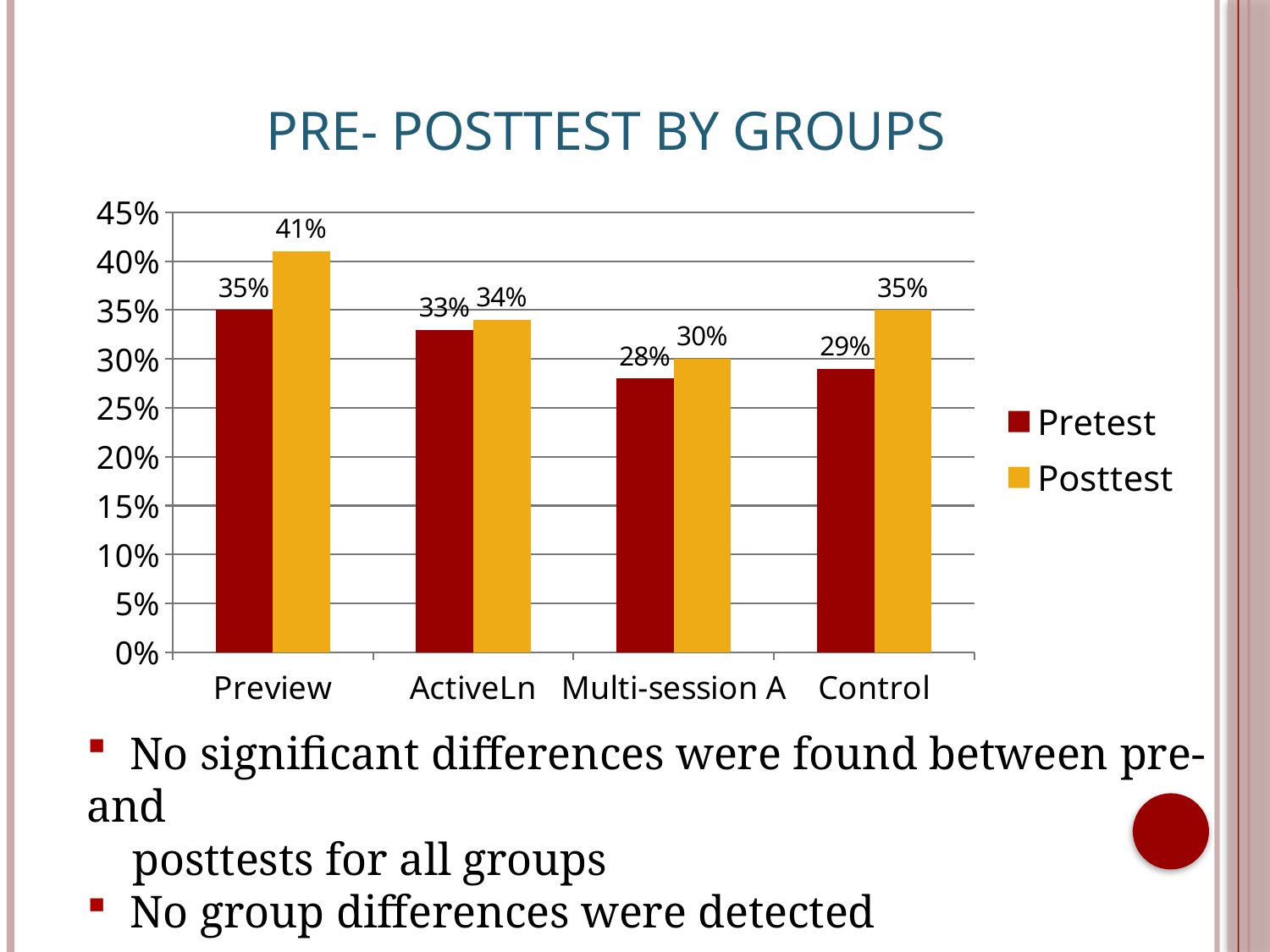
What is the Posttest value for Multi-session A? 30% Which group has the lowest Pretest value? Multi-session A How many series does the legend list? 2 Which group has the highest Posttest value? Preview What is the difference between the Posttest and Pretest values for Preview? 6% What is the difference between the Posttest and Pretest values for Control? 6% How many groups are shown on the x axis? 4 What is the title of the chart? PRE- POSTTEST BY GROUPS Which is larger, the Pretest value for ActiveLn or the Pretest value for Control? ActiveLn What kind of chart is shown on the slide? Bar chart What is the Pretest value for Control? 29% What is the Pretest value for Preview? 35%